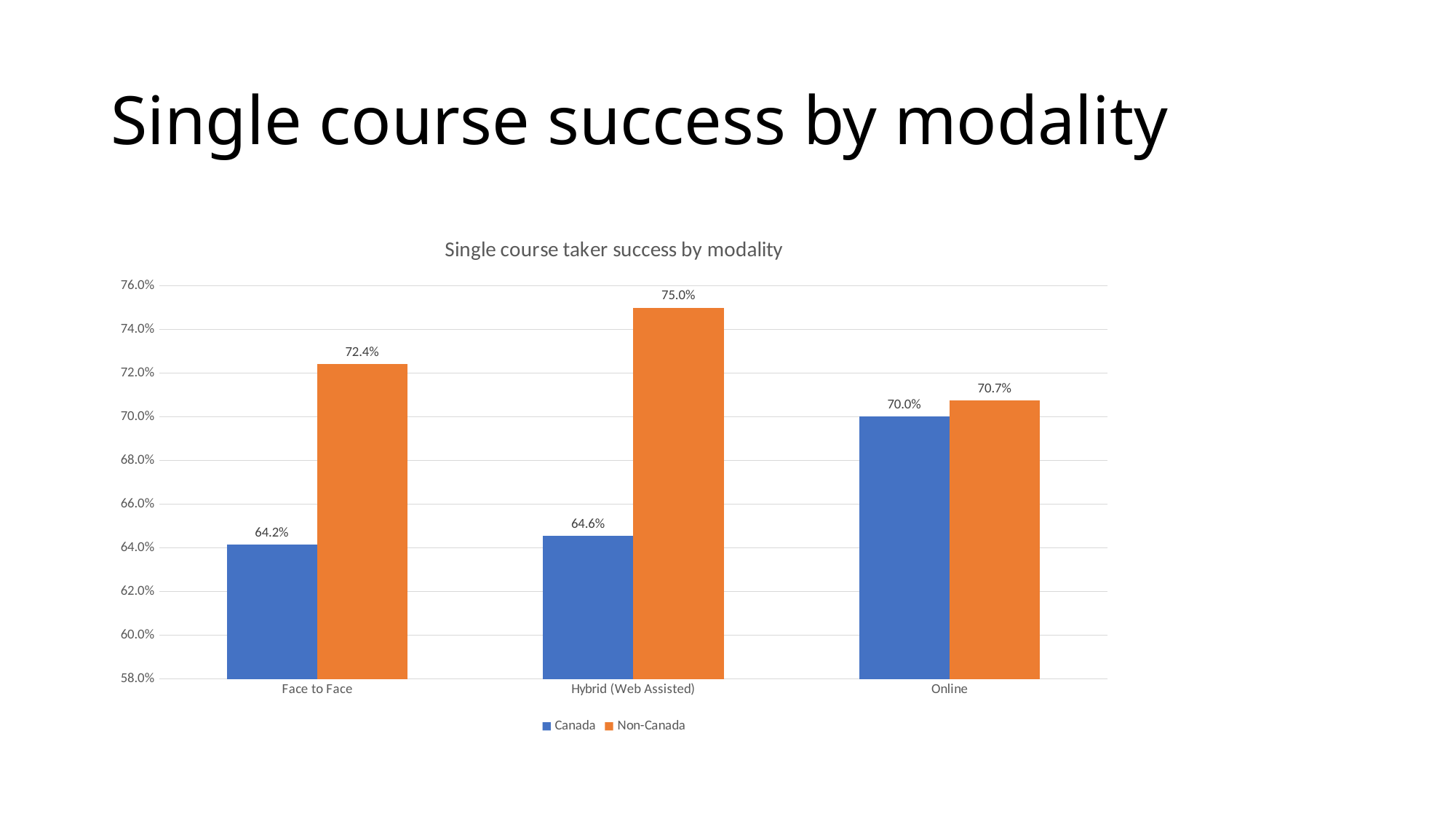
What is the Canada value for Face to Face? 64.2% Is the Canada value for Hybrid (Web Assisted) greater or less than 66.0%? less What is the Non-Canada value for Hybrid (Web Assisted)? 75.0% Which modality has the lowest Canada value? Face to Face What is the title of the chart? Single course taker success by modality How many modality categories are shown on the x axis? 3 How many series does the legend list? 2 What is the difference between the Non-Canada and Canada values for Face to Face? 8.2% What kind of chart is shown on the slide? bar chart What is the Non-Canada value for Online? 70.7% Which is larger for Online: the Canada value or the Non-Canada value? Non-Canada Which modality has the highest Non-Canada value? Hybrid (Web Assisted)